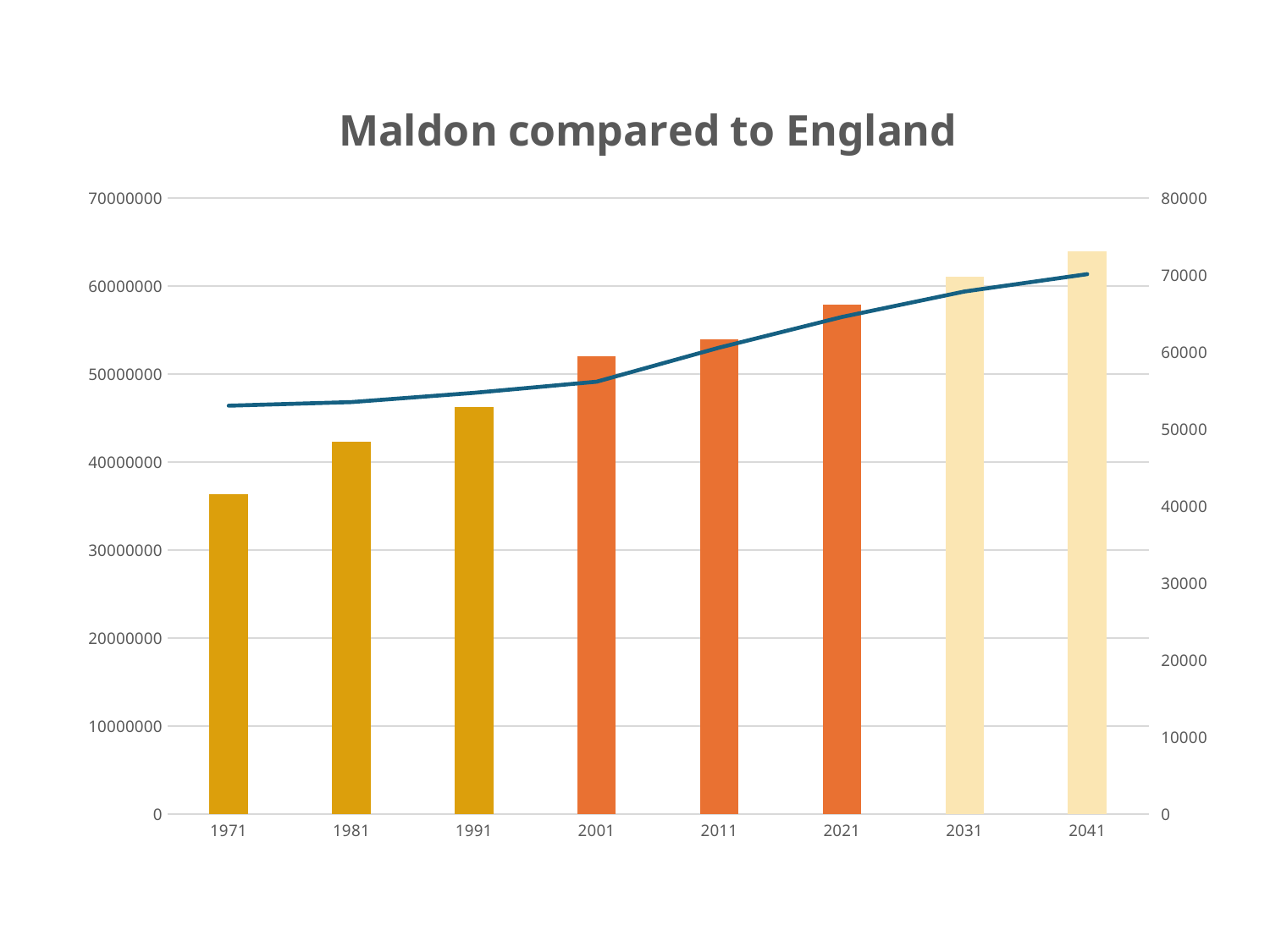
What is the title of the chart? Maldon compared to England Which year has the shortest bar? 1971 What kind of chart is shown on the slide? A bar chart with a line How many years are shown along the x axis of the chart? 8 Which years' bars are shaded in the palest colour? 2031 and 2041 Which year has the tallest bar? 2041 Which bar is taller, 2011 or 2021? 2021 Do the bar values rise or fall from 1971 to 2041? Rise